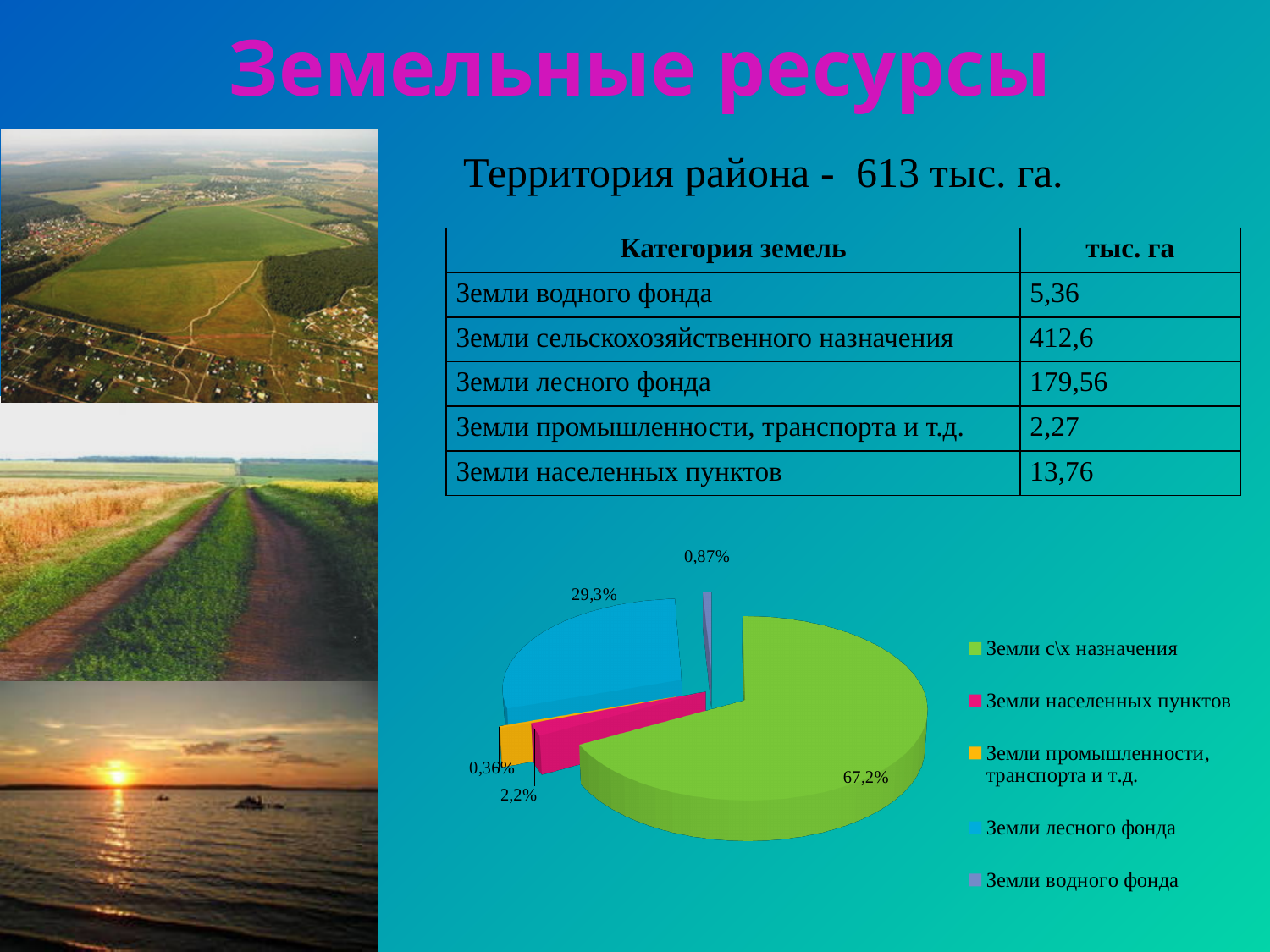
Which is larger: the slice for "Земли лесного фонда" or the slice for "Земли населенных пунктов"? Земли лесного фонда What share of the pie does "Земли промышленности, транспорта и т.д." take? 0,36% Which category has the smallest slice of the pie? Земли промышленности, транспорта и т.д. What kind of chart is shown on the slide? pie chart What share of the pie does "Земли с\х назначения" take? 67,2% What is the difference in percentage points between the "Земли с\х назначения" slice and the "Земли лесного фонда" slice? 37,9% What share of the pie does "Земли водного фонда" take? 0,87% Which category has the largest slice of the pie? Земли с\х назначения How many slices does the pie chart have? 5 What colour is the slice for "Земли с\х назначения"? green